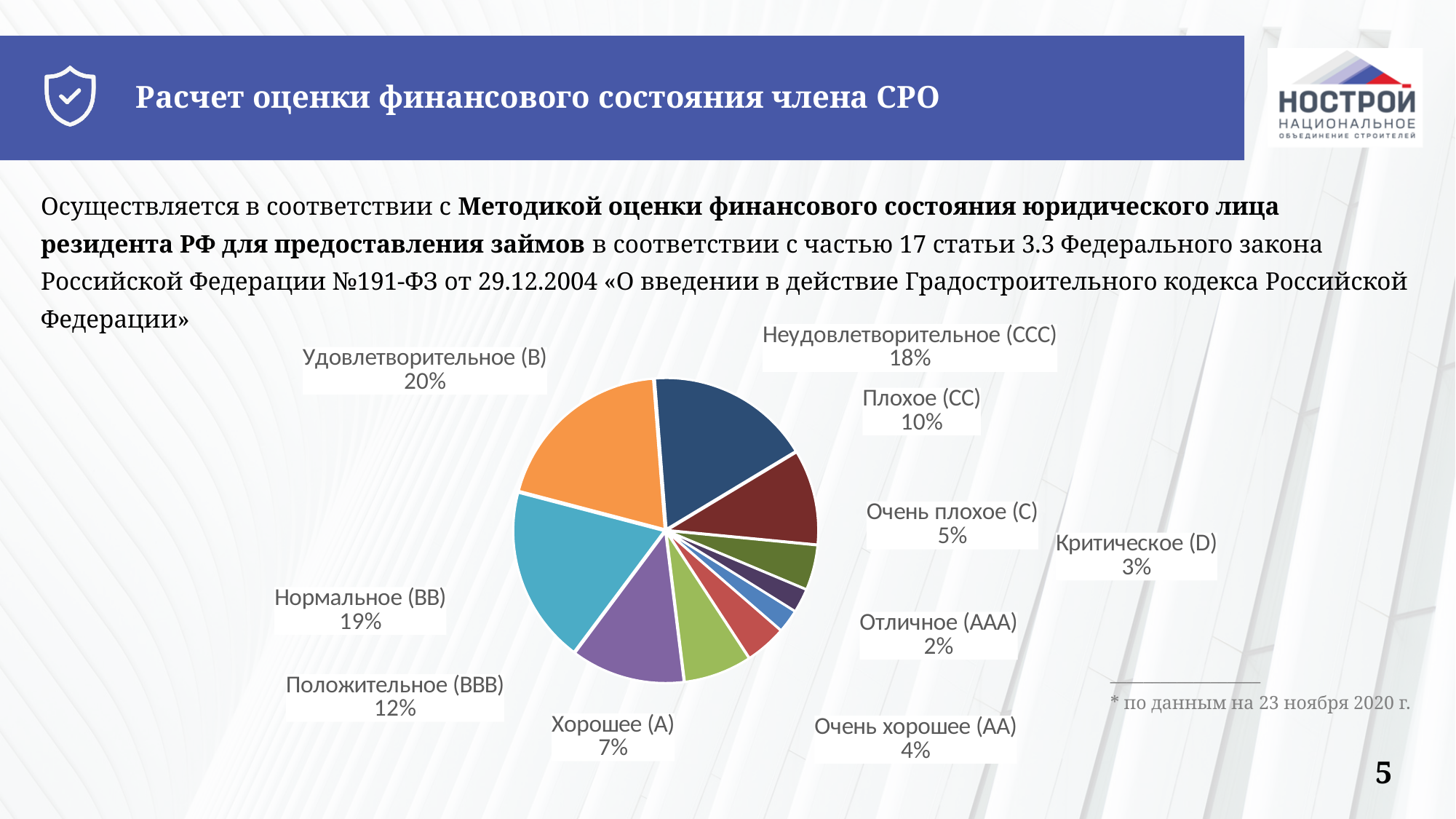
Which is larger: the share of Очень плохое (C) or the share of Очень хорошее (AA)? Очень плохое (C) What is the value for Положительное (BBB)? 12% What colour is the slice for Удовлетворительное (B)? Orange What kind of chart is shown on the slide? Pie chart How many categories (slices) does the pie chart have? 10 What is the value for Неудовлетворительное (CCC)? 18% What is the difference between the shares of Нормальное (BB) and Хорошее (A)? 12% What is the value for Плохое (CC)? 10% Which category has the largest share of the pie? Удовлетворительное (B) Which category has the smallest share of the pie? Отличное (AAA) What share of the pie does Удовлетворительное (B) have? 20% What is the combined share of Критическое (D) and Отличное (AAA)? 5%